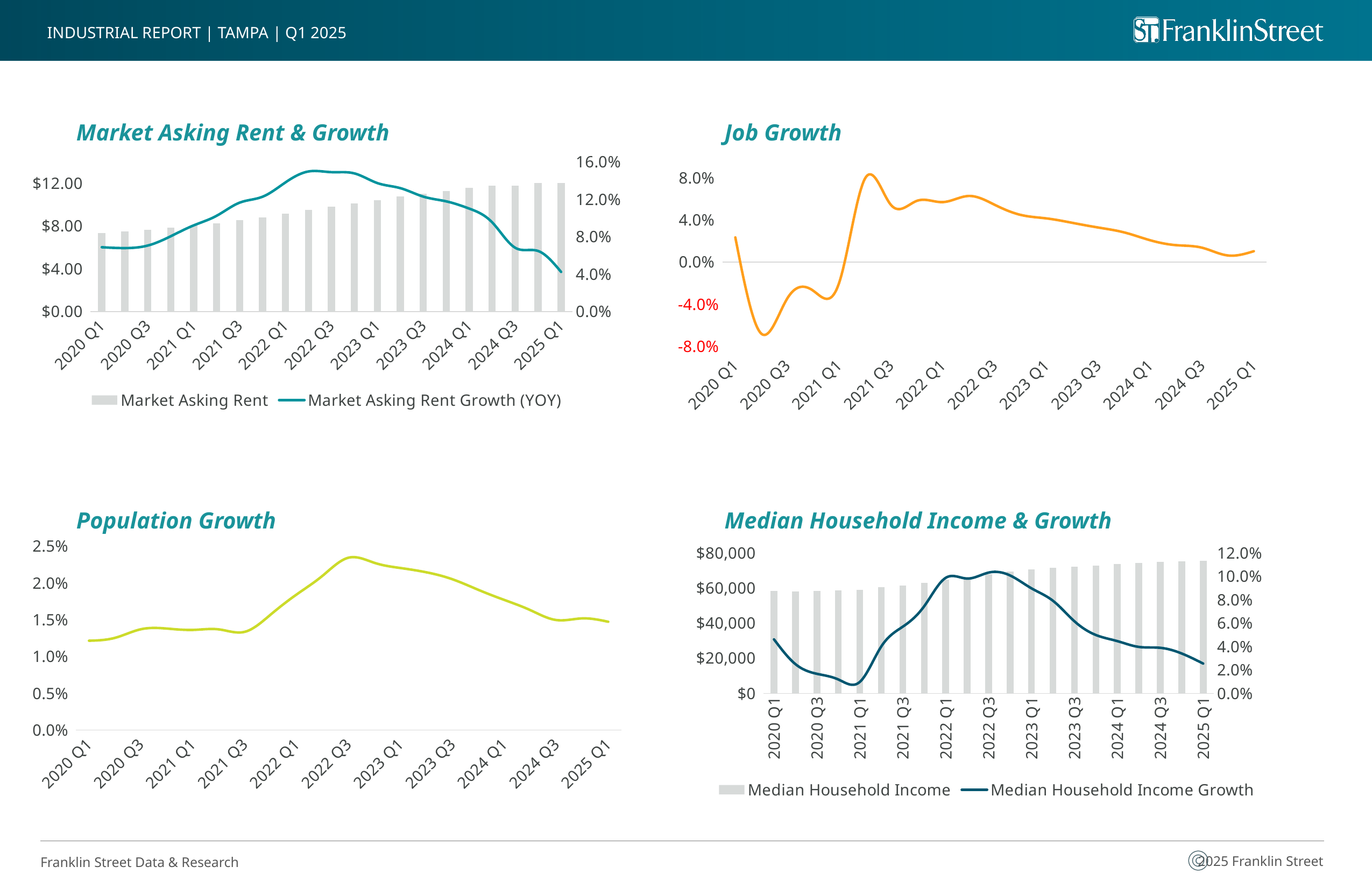
In the Job Growth chart, is the value for 2021 Q3 greater or less than 4.0%? greater In the Market Asking Rent & Growth chart, do the Market Asking Rent bars rise or fall from 2020 Q1 to 2025 Q1? rise In the Population Growth chart, does the line rise or fall from 2022 Q3 to 2025 Q1? fall In the Population Growth chart, which labelled quarter has the highest value? 2022 Q3 In the Market Asking Rent & Growth chart, is the Market Asking Rent Growth (YOY) value for 2025 Q1 greater or less than 8.0%? less In the Market Asking Rent & Growth chart, is the Market Asking Rent for 2025 Q1 greater or less than $8.00? greater How many series does the legend of the Market Asking Rent & Growth chart list? 2 What kind of chart is the Job Growth chart? line chart